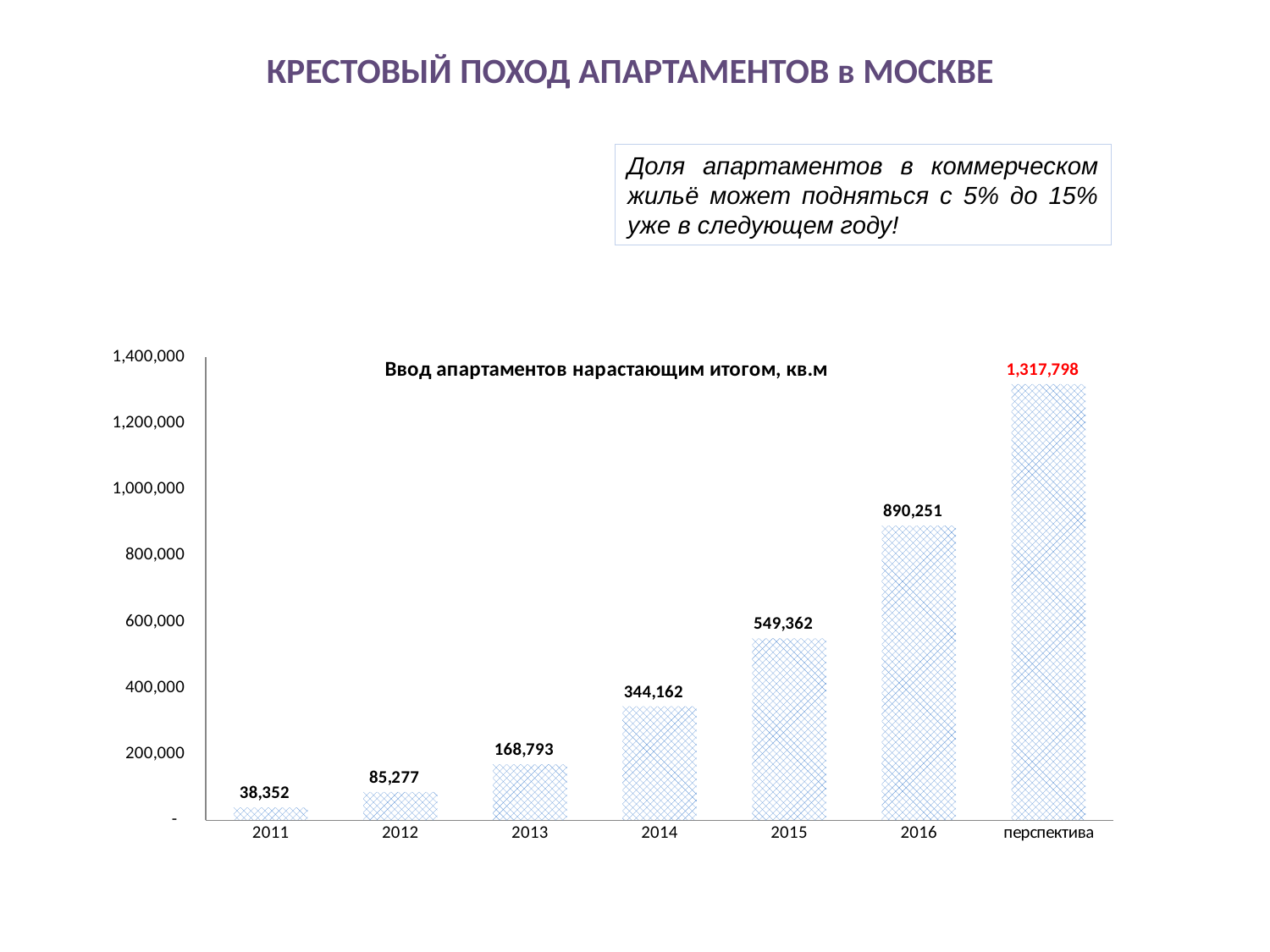
What is the value for 2014 in the chart "Ввод апартаментов нарастающим итогом, кв.м"? 344,162 Which is larger, the value for 2013 or the value for 2012? 2013 What kind of chart is shown on the slide? bar chart What is the difference between the values for 2014 and 2013? 175,369 Which category has the highest value in the chart? перспектива What is the value for 2011 in the chart? 38,352 Which category has the lowest value in the chart? 2011 What is the value shown for "перспектива" in the chart? 1,317,798 Is the value for 2016 greater or less than 800,000? greater How many categories are shown on the x axis of the chart? 7 Do the values rise or fall from 2011 to 2016? rise What is the difference between the values for 2016 and 2015? 340,889